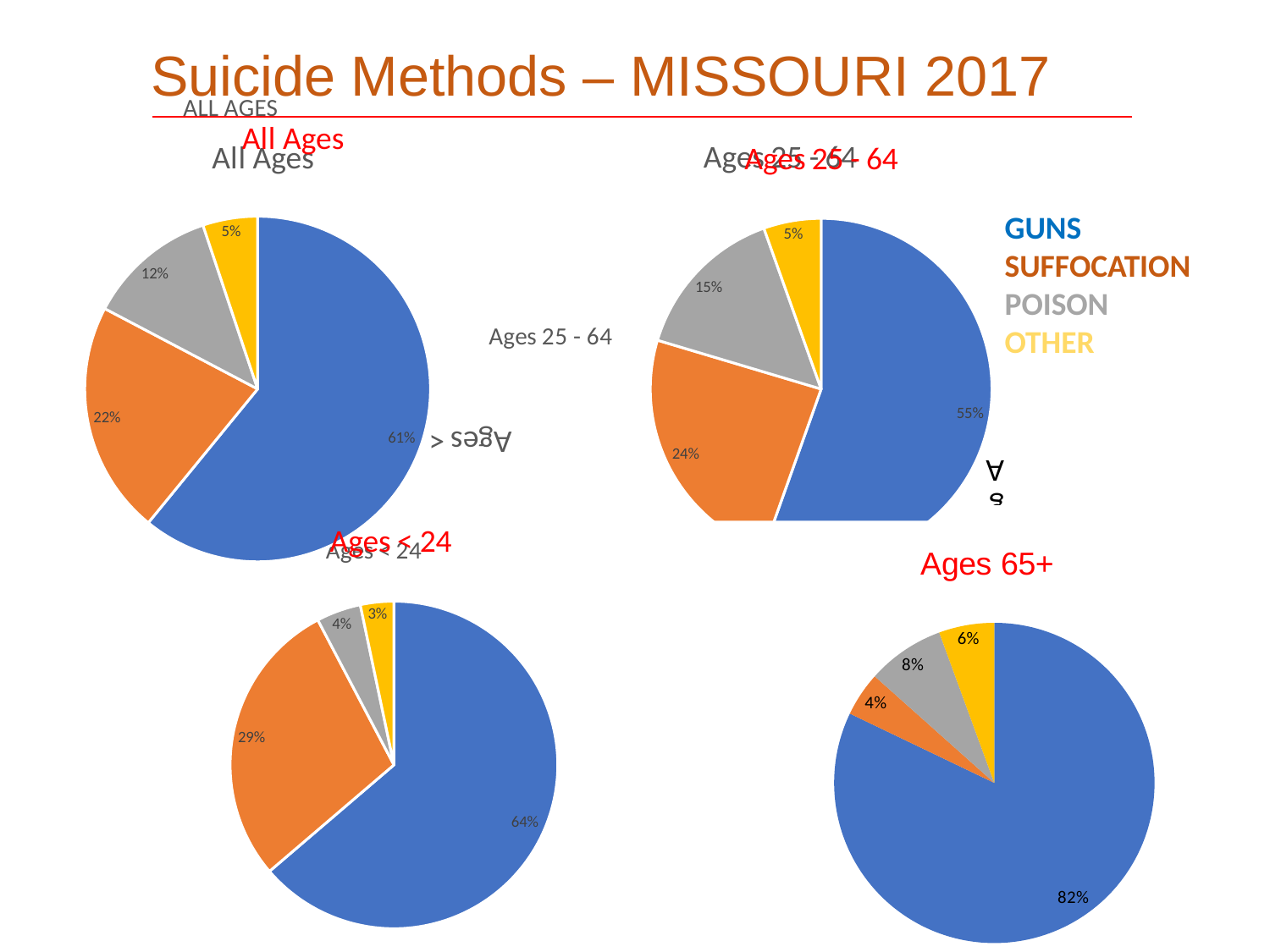
In the Ages < 24 pie chart, what is the difference between the guns share and the suffocation share? 35% In the Ages 65+ pie chart, what percentage is shown for guns? 82% In the All Ages pie chart, which method has the largest slice? Guns In the Ages 65+ pie chart, which method has the smallest slice? Suffocation Which method does the orange colour represent in the legend? Suffocation Is the guns share larger in the Ages 65+ pie chart or in the Ages 25 - 64 pie chart? Ages 65+ How many pie charts are on the slide? 4 What type of chart is used for the Ages < 24 data? Pie chart In the Ages < 24 pie chart, what percentage is shown for poison? 4% In the Ages 25 - 64 pie chart, what percentage is shown for suffocation? 24% In the All Ages pie chart, what percentage is shown for the guns slice? 61% How many slices does the Ages 25 - 64 pie chart have? 4